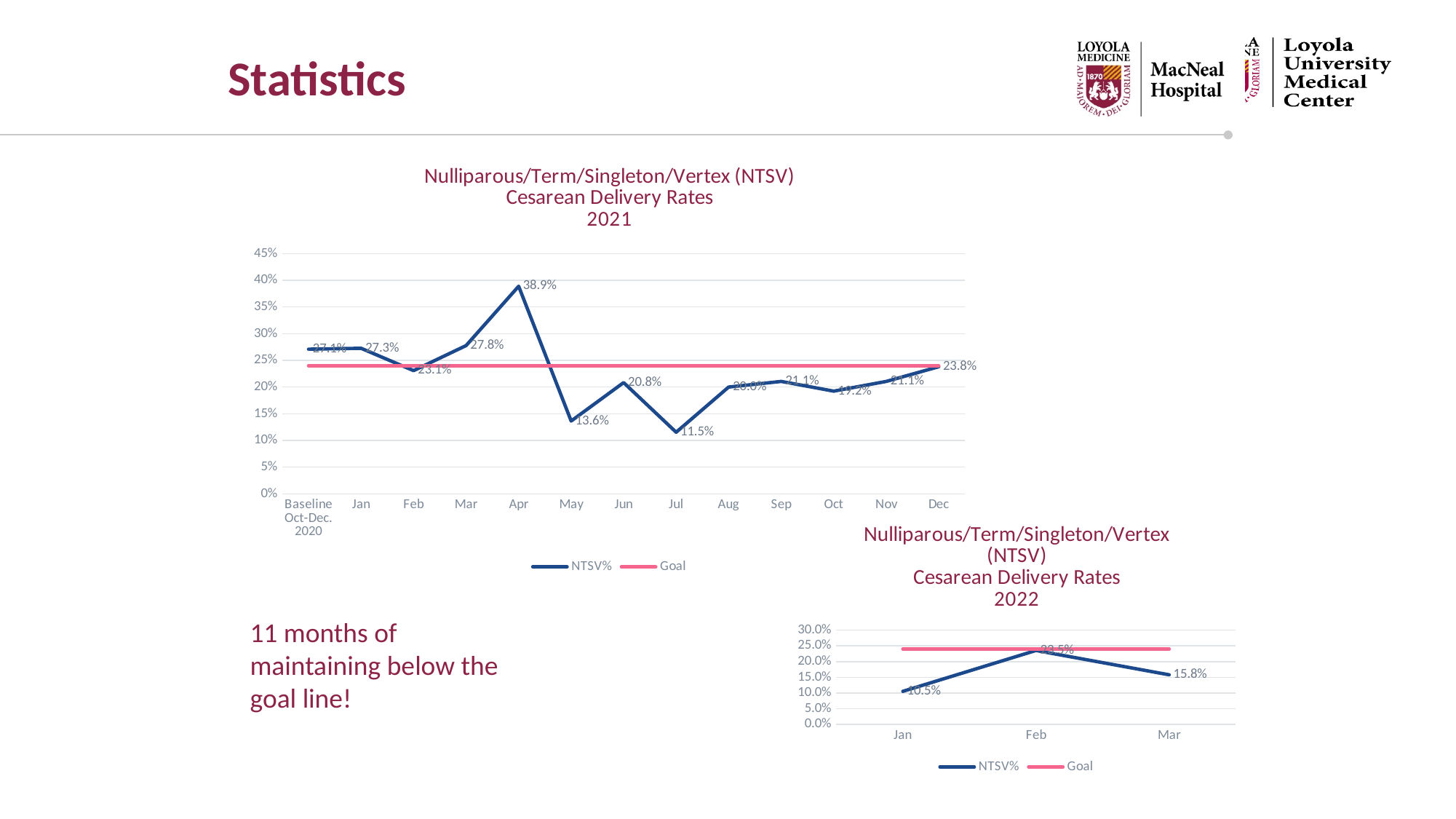
In the 2021 NTSV Cesarean Delivery Rates chart, how many series does the legend list? 2 In the 2021 NTSV Cesarean Delivery Rates chart, which month has the highest NTSV% value? Apr What kind of chart is the 2021 NTSV Cesarean Delivery Rates chart? Line chart In the 2022 NTSV Cesarean Delivery Rates chart, which month has the lowest NTSV% value? Jan In the 2021 NTSV Cesarean Delivery Rates chart, what is the difference between the NTSV% values for Apr and Jul? 27.4 percentage points In the 2021 NTSV Cesarean Delivery Rates chart, which is larger, the NTSV% value for Mar or for Jun? Mar In the 2021 NTSV Cesarean Delivery Rates chart, what is the NTSV% value for Apr? 38.9% In the 2021 NTSV Cesarean Delivery Rates chart, how many points are plotted along the x axis? 13 In the 2022 NTSV Cesarean Delivery Rates chart, is the NTSV% value for Feb greater or less than 20.0%? greater In the 2021 NTSV Cesarean Delivery Rates chart, what is the NTSV% value for Dec? 23.8% In the 2021 NTSV Cesarean Delivery Rates chart, which month has the lowest NTSV% value? Jul In the 2022 NTSV Cesarean Delivery Rates chart, what is the NTSV% value for Mar? 15.8%